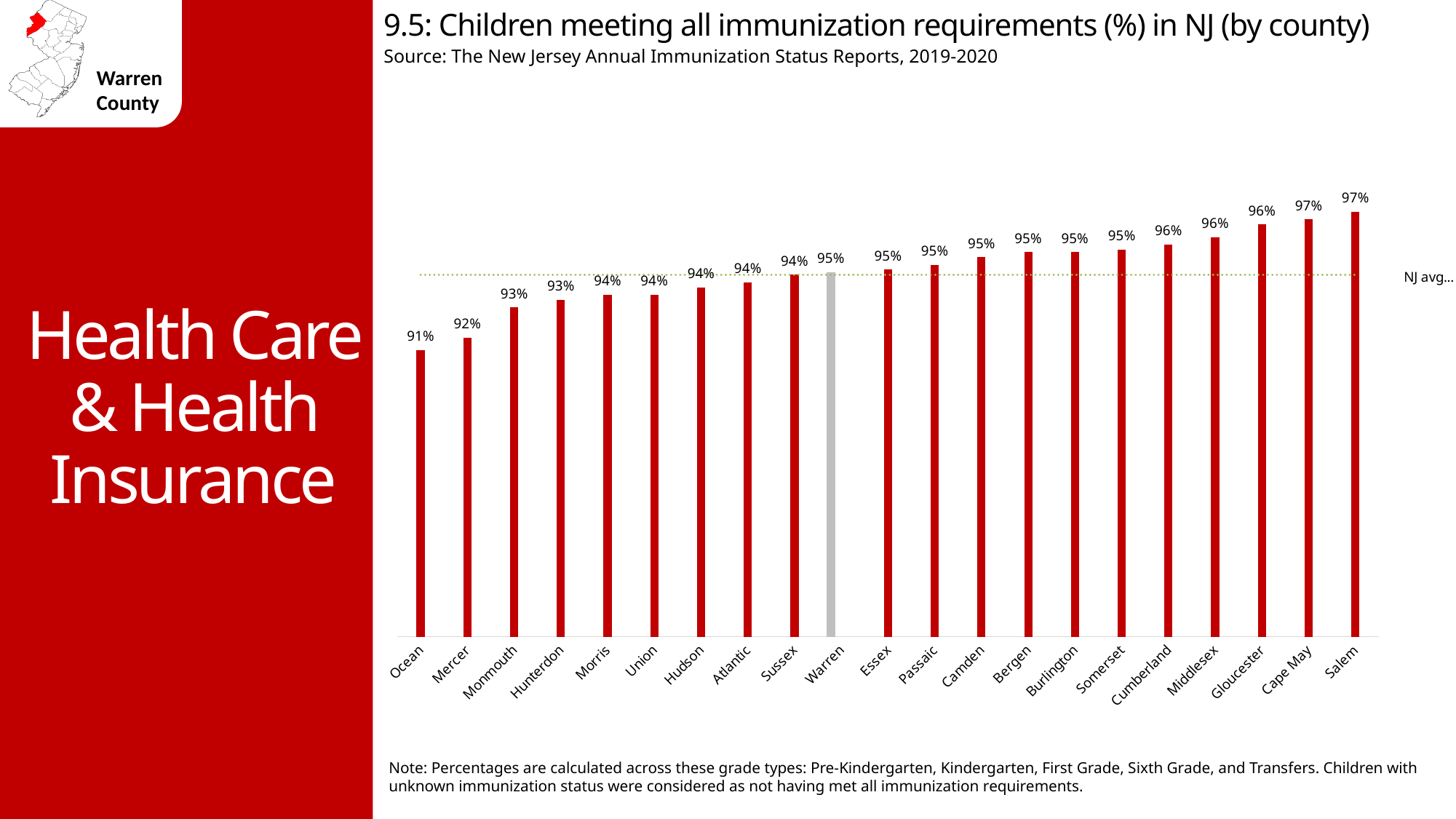
What is the value shown for Gloucester County? 96% How many counties are shown in the chart? 21 What is the difference in percentage points between Salem County and Ocean County? 6 percentage points Which county has the lowest percentage of children meeting all immunization requirements? Ocean What is the value shown for Ocean County? 91% Which has a higher value, Monmouth County or Cape May County? Cape May Which has a higher value, Ocean County or Mercer County? Mercer What is the value shown for Hunterdon County? 93% What is the difference in percentage points between Warren County and Mercer County? 3 percentage points Do the values generally rise or fall from left to right across the counties? Rise What kind of chart is used on this slide? Bar chart What percentage of children in Warren County met all immunization requirements? 95%